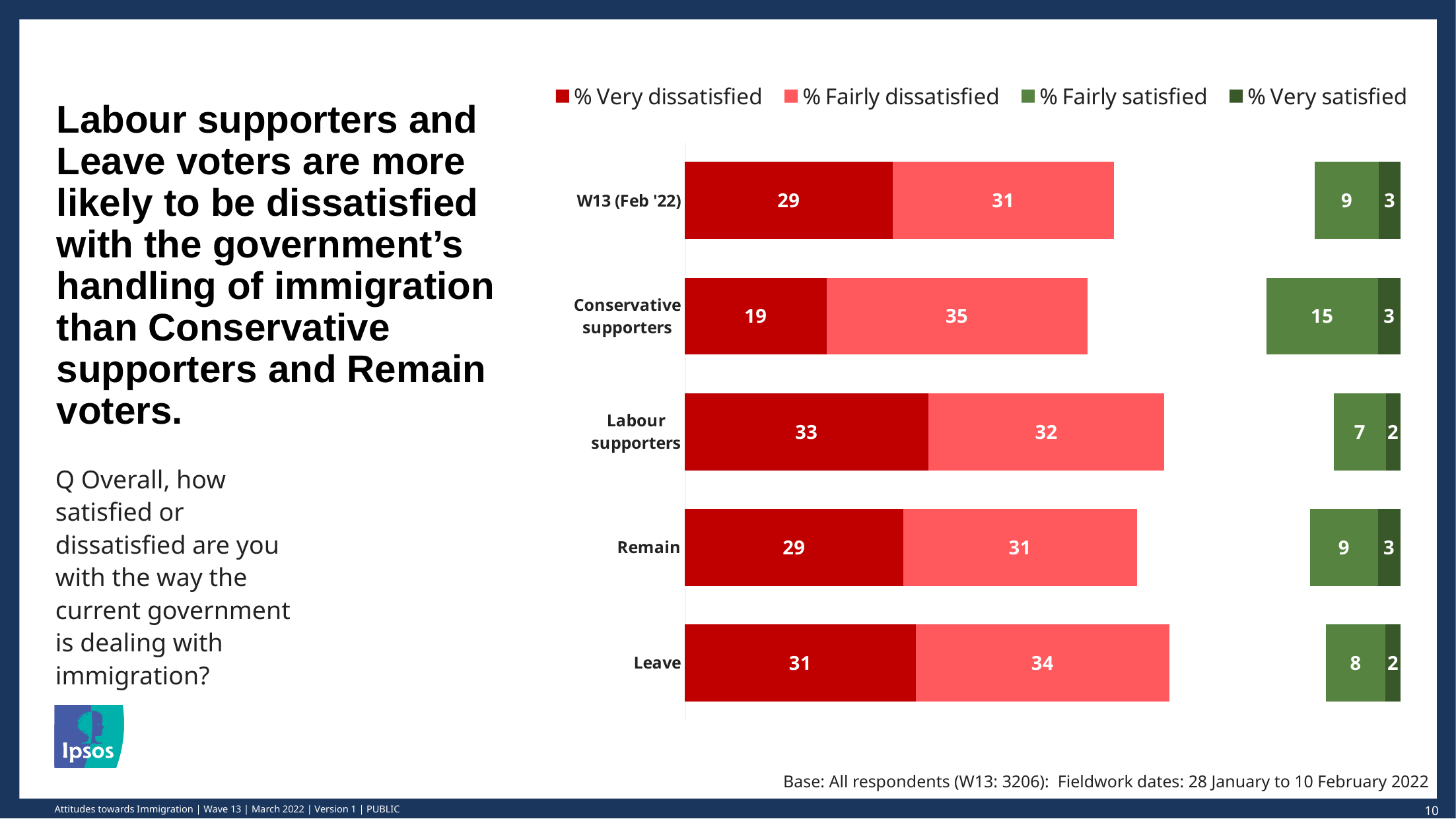
What is the % Fairly satisfied value for Conservative supporters? 15 What is the % Very dissatisfied value for Labour supporters? 33 What is the combined total of % Very dissatisfied and % Fairly dissatisfied for Leave voters? 65 Which is larger: the % Fairly dissatisfied value for Conservative supporters or for Labour supporters? Conservative supporters How many categories are shown on the chart? 5 What is the % Very satisfied value for Remain voters? 3 Which category has the highest % Fairly satisfied value? Conservative supporters Which category has the highest % Very dissatisfied value? Labour supporters What is the difference between the % Very dissatisfied values for Labour supporters and Conservative supporters? 14 What is the % Fairly dissatisfied value for Leave voters? 34 How many series does the legend list? 4 Which category has the lowest % Very dissatisfied value? Conservative supporters